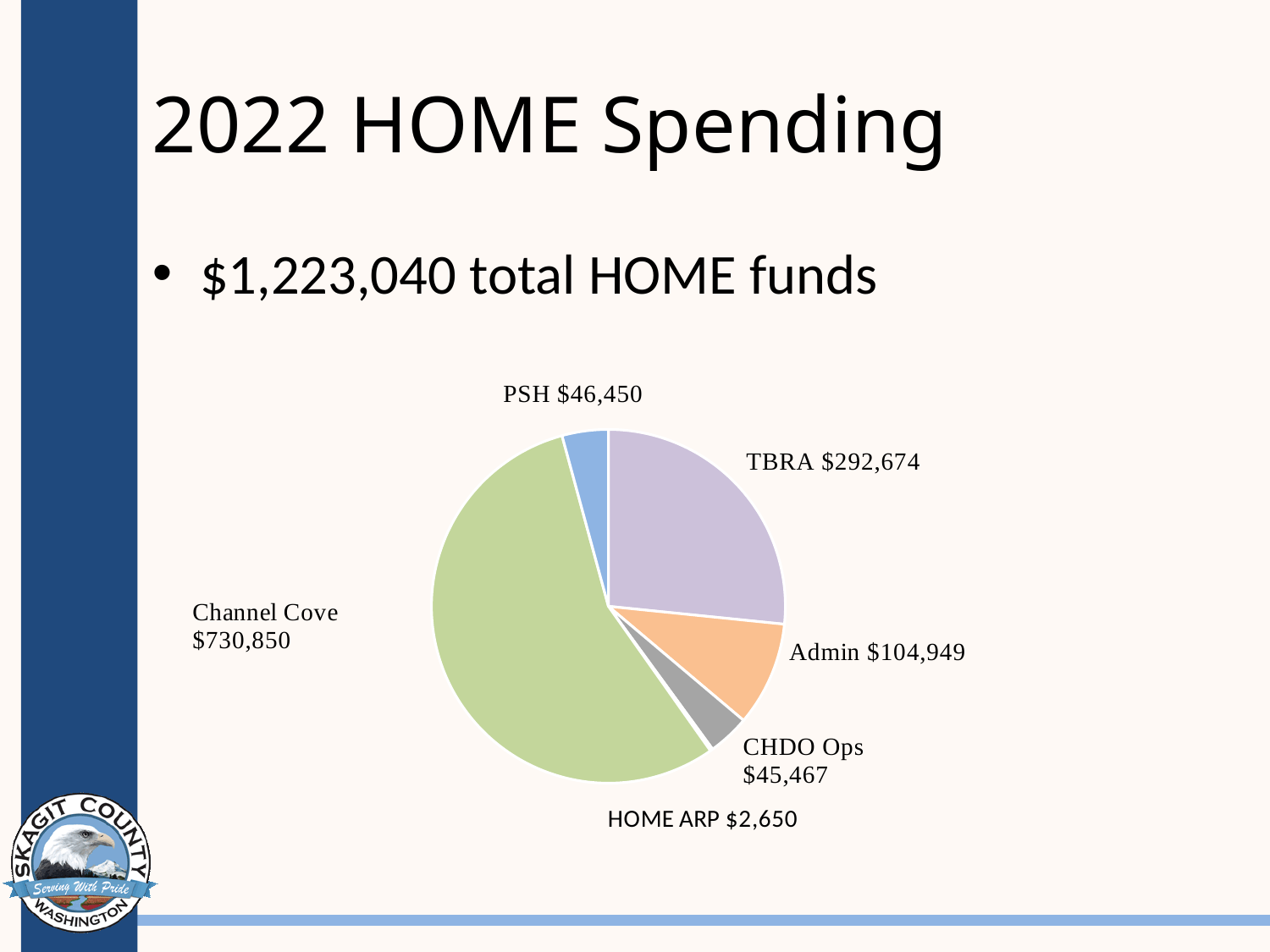
To the nearest whole percent, what share of the total does Channel Cove represent? 60% What is the difference between the TBRA value and the Admin value? $187,725 Which category has the largest slice of the pie? Channel Cove What is the value shown for HOME ARP? $2,650 How many slices does the pie chart have? 6 What is the value shown for Channel Cove? $730,850 What type of chart is shown on the slide? Pie chart What is the total of all the slices in the pie chart? $1,223,040 What is the value shown for TBRA? $292,674 Which is larger, the TBRA value or the Admin value? TBRA Which category has the smallest slice of the pie? HOME ARP What is the value shown for CHDO Ops? $45,467